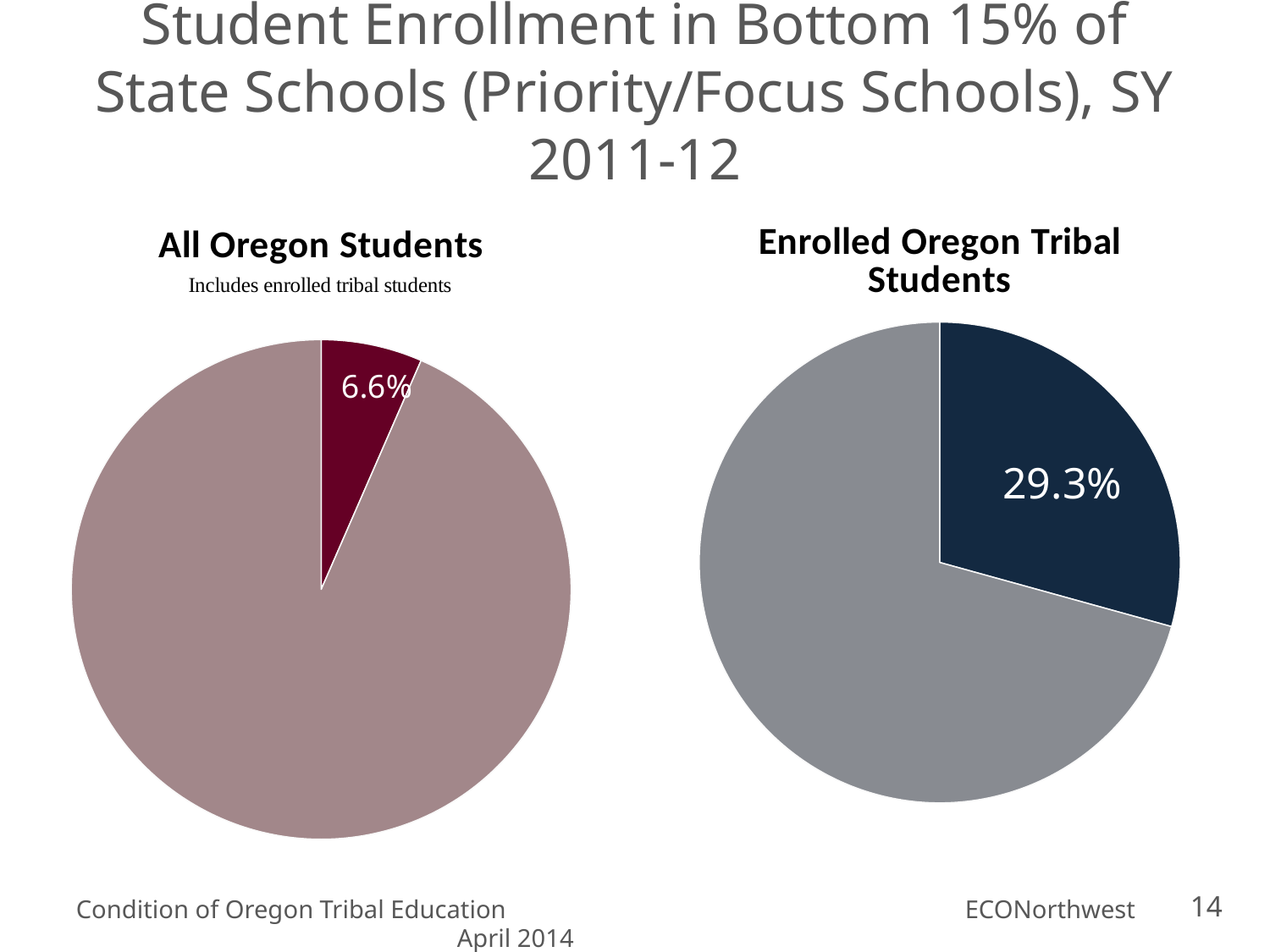
In the 'All Oregon Students' chart, what percentage is shown on the labelled slice? 6.6% How many slices does the 'All Oregon Students' pie chart have? 2 In the 'All Oregon Students' chart, is the labelled slice the larger or the smaller of the two slices? smaller How many pie charts are on the slide? 2 Which chart shows the larger labelled share, 'All Oregon Students' or 'Enrolled Oregon Tribal Students'? Enrolled Oregon Tribal Students What kind of chart is the 'All Oregon Students' chart? pie chart In the 'Enrolled Oregon Tribal Students' chart, is the labelled slice the larger or the smaller of the two slices? smaller In the 'Enrolled Oregon Tribal Students' chart, what percentage is shown on the labelled slice? 29.3% How many slices does the 'Enrolled Oregon Tribal Students' pie chart have? 2 What is the difference between the labelled share in the 'Enrolled Oregon Tribal Students' chart and the labelled share in the 'All Oregon Students' chart? 22.7% What kind of chart is the 'Enrolled Oregon Tribal Students' chart? pie chart What note appears under the title of the 'All Oregon Students' chart? Includes enrolled tribal students